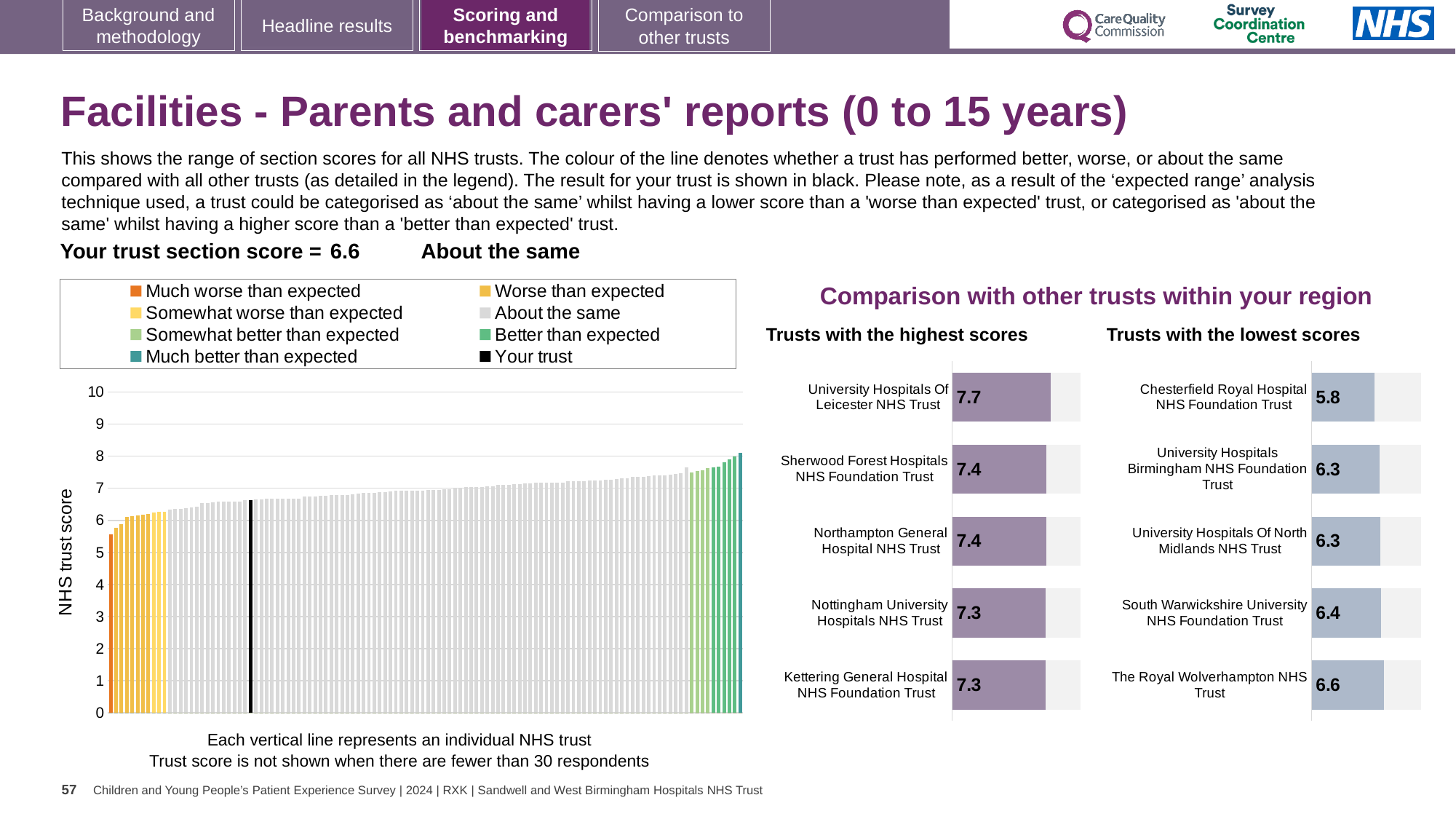
In the 'Trusts with the highest scores' chart, what is the difference between the scores of University Hospitals Of Leicester NHS Trust and Nottingham University Hospitals NHS Trust? 0.4 In the 'Trusts with the lowest scores' chart, which has the larger score: University Hospitals Of North Midlands NHS Trust or The Royal Wolverhampton NHS Trust? The Royal Wolverhampton NHS Trust In the 'Trusts with the lowest scores' chart, what is the score for South Warwickshire University NHS Foundation Trust? 6.4 In the 'Trusts with the lowest scores' chart, which trust has the lowest score? Chesterfield Royal Hospital NHS Foundation Trust In the 'Trusts with the lowest scores' chart, what is the difference between the scores of The Royal Wolverhampton NHS Trust and Chesterfield Royal Hospital NHS Foundation Trust? 0.8 In the main chart on the left showing all NHS trusts, what is the section score for your trust (the black line)? 6.6 In the 'Trusts with the highest scores' chart, how many trusts are listed? 5 In the 'Trusts with the highest scores' chart, which trust has the highest score? University Hospitals Of Leicester NHS Trust In the 'Trusts with the highest scores' chart, what is the score for University Hospitals Of Leicester NHS Trust? 7.7 In the main chart on the left showing all NHS trusts, how many categories does the legend list? 8 In the 'Trusts with the lowest scores' chart, what is the score for Chesterfield Royal Hospital NHS Foundation Trust? 5.8 In the 'Trusts with the highest scores' chart, what is the score for Kettering General Hospital NHS Foundation Trust? 7.3